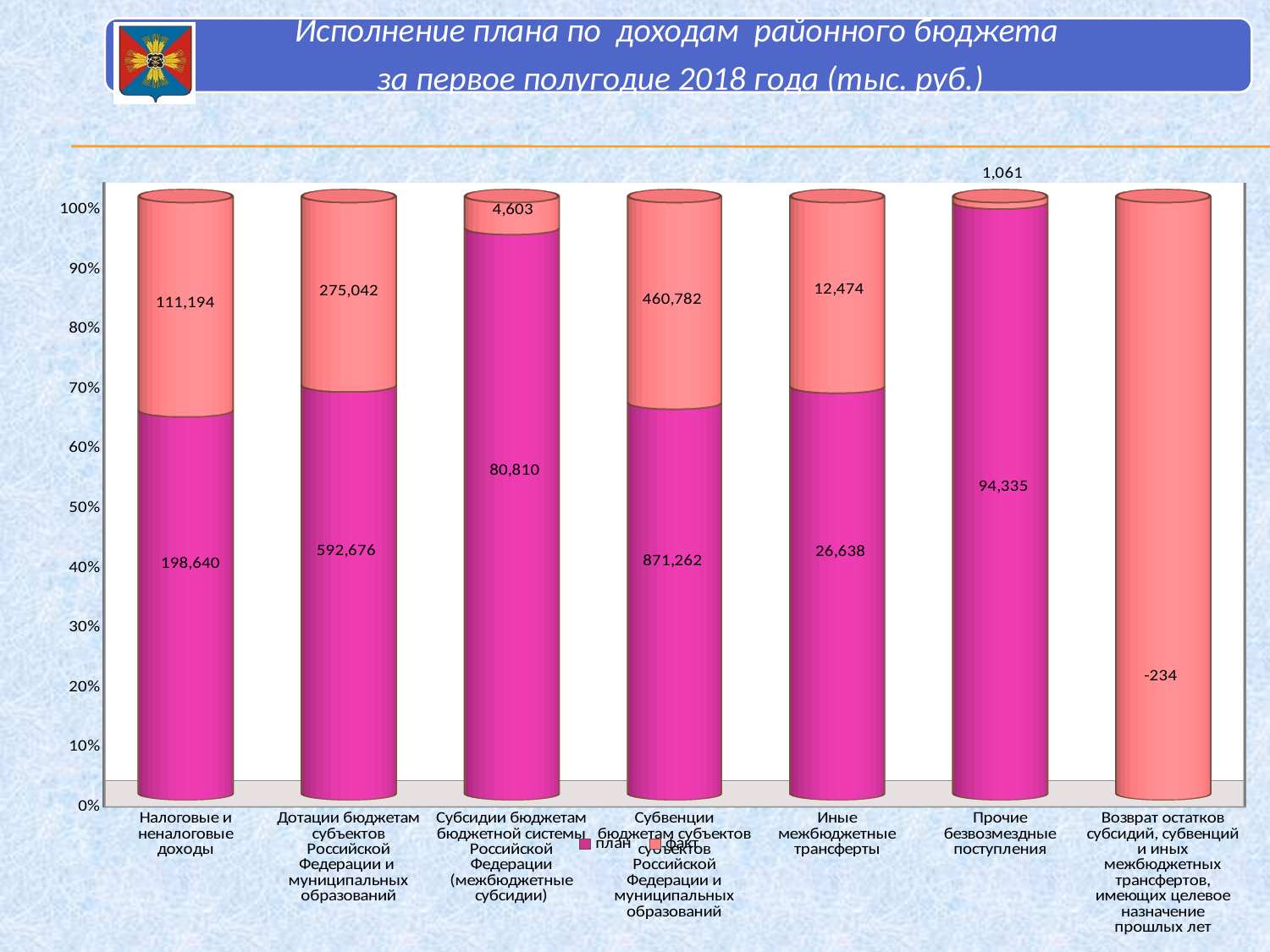
Which category has the highest план value? Субвенции бюджетам субъектов Российской Федерации и муниципальных образований What is the факт value for Возврат остатков субсидий, субвенций и иных межбюджетных трансфертов, имеющих целевое назначение прошлых лет? -234 What is the план (plan) value for Налоговые и неналоговые доходы? 198,640 How many categories are shown on the x axis? 7 What kind of chart is shown on the slide? stacked bar chart How many series does the legend list? 2 What is the факт (actual) value for Дотации бюджетам субъектов Российской Федерации и муниципальных образований? 275,042 Which category has the lowest факт value? Возврат остатков субсидий, субвенций и иных межбюджетных трансфертов, имеющих целевое назначение прошлых лет What is the difference between the план and факт values for Иные межбюджетные трансферты? 14,164 What is the sum of the план and факт values for Налоговые и неналоговые доходы? 309,834 What is the факт value for Субсидии бюджетам бюджетной системы Российской Федерации (межбюджетные субсидии)? 4,603 Which is larger: the факт value for Прочие безвозмездные поступления or the факт value for Субсидии бюджетам бюджетной системы Российской Федерации (межбюджетные субсидии)? Субсидии бюджетам бюджетной системы Российской Федерации (межбюджетные субсидии)